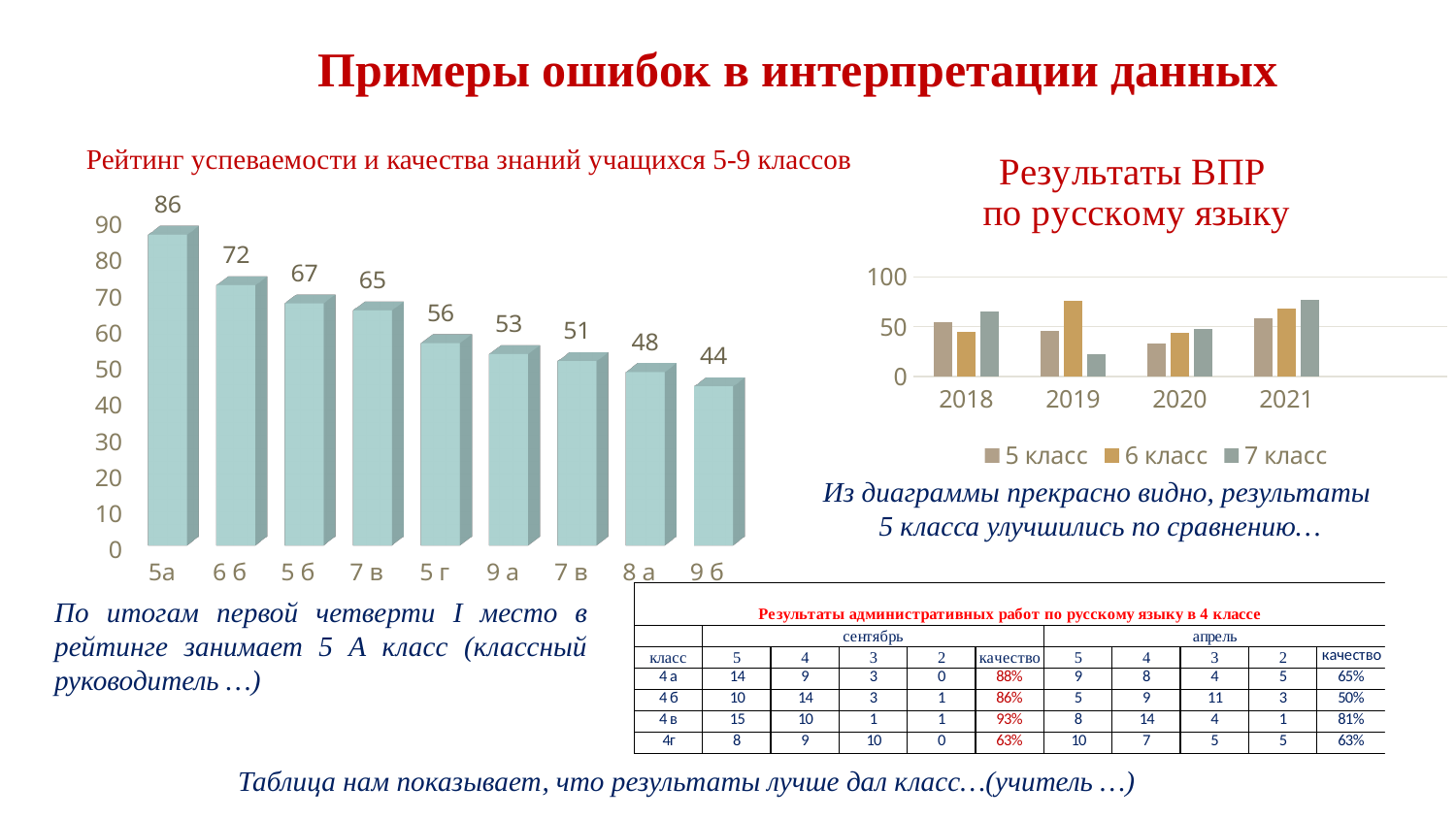
In the chart 'Рейтинг успеваемости и качества знаний учащихся 5-9 классов', do the values rise or fall from left to right? fall In the chart 'Рейтинг успеваемости и качества знаний учащихся 5-9 классов', what is the difference between the values for 5а and 6б? 14 In the chart 'Рейтинг успеваемости и качества знаний учащихся 5-9 классов', what is the value for 9б? 44 In the chart 'Рейтинг успеваемости и качества знаний учащихся 5-9 классов', which category has the lowest value? 9б In the chart 'Результаты ВПР по русскому языку', how many series does the legend list? 3 In the chart 'Рейтинг успеваемости и качества знаний учащихся 5-9 классов', which is larger, the value for 5б or the value for 9а? 5б In the chart 'Результаты ВПР по русскому языку', is the value for 7 класс in 2019 greater or less than 50? less In the chart 'Рейтинг успеваемости и качества знаний учащихся 5-9 классов', which category has the highest value? 5а In the chart 'Результаты ВПР по русскому языку', is the value for 6 класс in 2019 greater or less than 50? greater In the chart 'Рейтинг успеваемости и качества знаний учащихся 5-9 классов', what is the value for 5а? 86 In the chart 'Рейтинг успеваемости и качества знаний учащихся 5-9 классов', how many bars are plotted? 9 In the chart 'Рейтинг успеваемости и качества знаний учащихся 5-9 классов', what is the value for 5г? 56